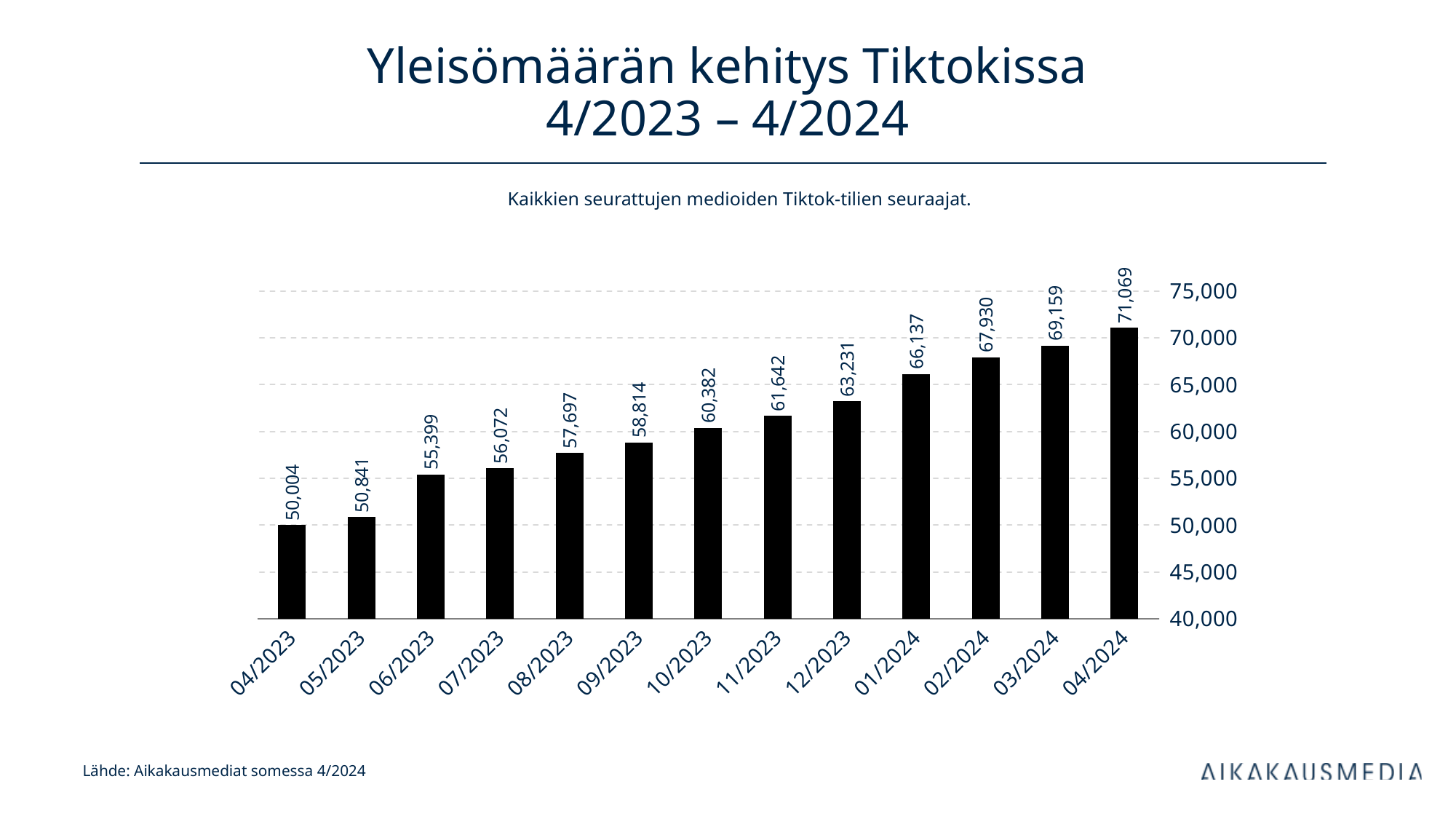
Which month has the lowest value? 04/2023 How many months are shown on the x axis? 13 What is the value for 04/2024? 71,069 Which is larger, the value for 08/2023 or the value for 12/2023? 12/2023 Is the value for 01/2024 greater or less than 65,000? greater Do the values rise or fall from 04/2023 to 04/2024? rise What is the difference between the values for 03/2024 and 02/2024? 1,229 What is the difference between the values for 04/2024 and 04/2023? 21,065 What kind of chart is shown on the slide? bar chart What is the value for 04/2023? 50,004 Which month has the highest value? 04/2024 What is the value for 10/2023? 60,382